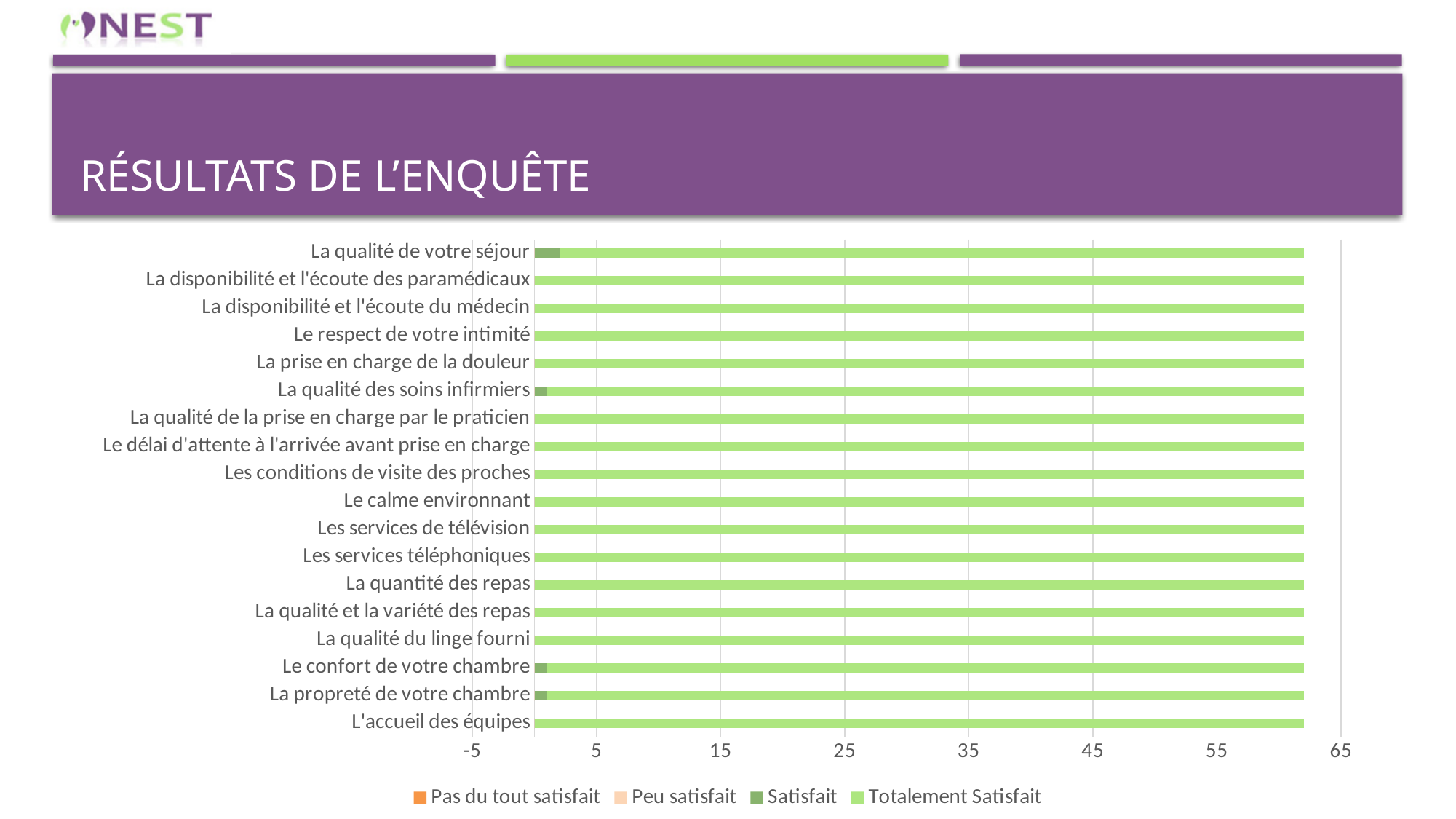
How many series does the legend list? 4 What kind of chart is shown on the slide? bar chart Which category is listed at the top of the chart? La qualité de votre séjour How many categories are plotted on the chart? 18 Is the 'Satisfait' value for 'La qualité de votre séjour' greater or less than 5? less Which series is shown in light green in the legend? Totalement Satisfait Is the 'Totalement Satisfait' value for 'L'accueil des équipes' greater or less than 55? greater Is the 'Totalement Satisfait' value for 'La quantité des repas' greater or less than 45? greater What is the title of the slide containing the chart? RÉSULTATS DE L'ENQUÊTE